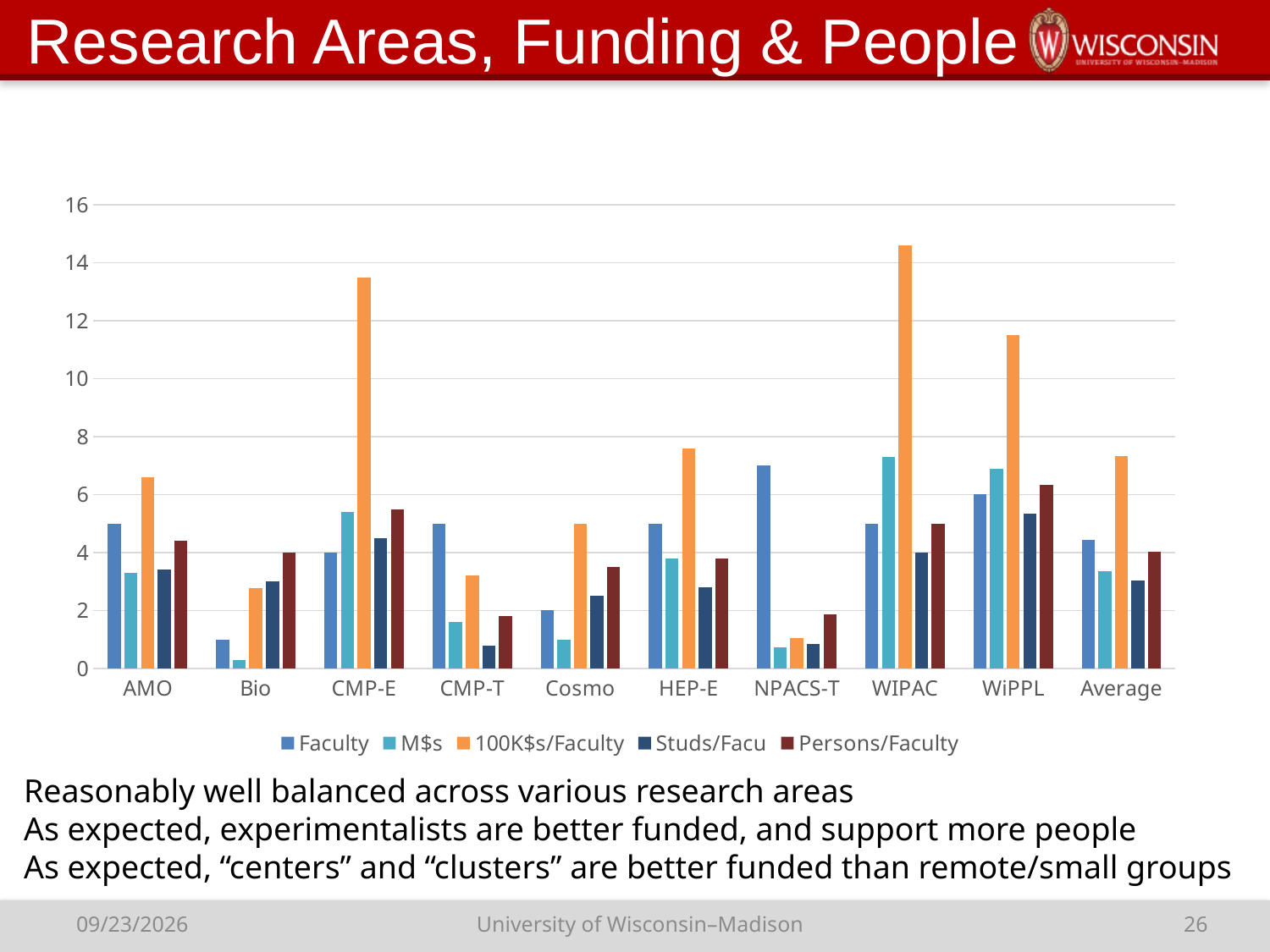
What kind of chart is shown on the slide? bar chart How many research-area categories are shown on the x axis? 10 Which colour represents the 100K$s/Faculty series in the legend? orange Which category has the highest Faculty bar? NPACS-T Which is larger, the Faculty value for AMO or for Bio? AMO Which is larger, the 100K$s/Faculty value for CMP-E or for WiPPL? CMP-E Is the Faculty value for Bio greater or less than 2? less Is the 100K$s/Faculty value for WIPAC greater or less than 14? greater Is the M$s value for NPACS-T greater or less than 2? less How many series does the legend list? 5 Which category has the highest 100K$s/Faculty bar? WIPAC